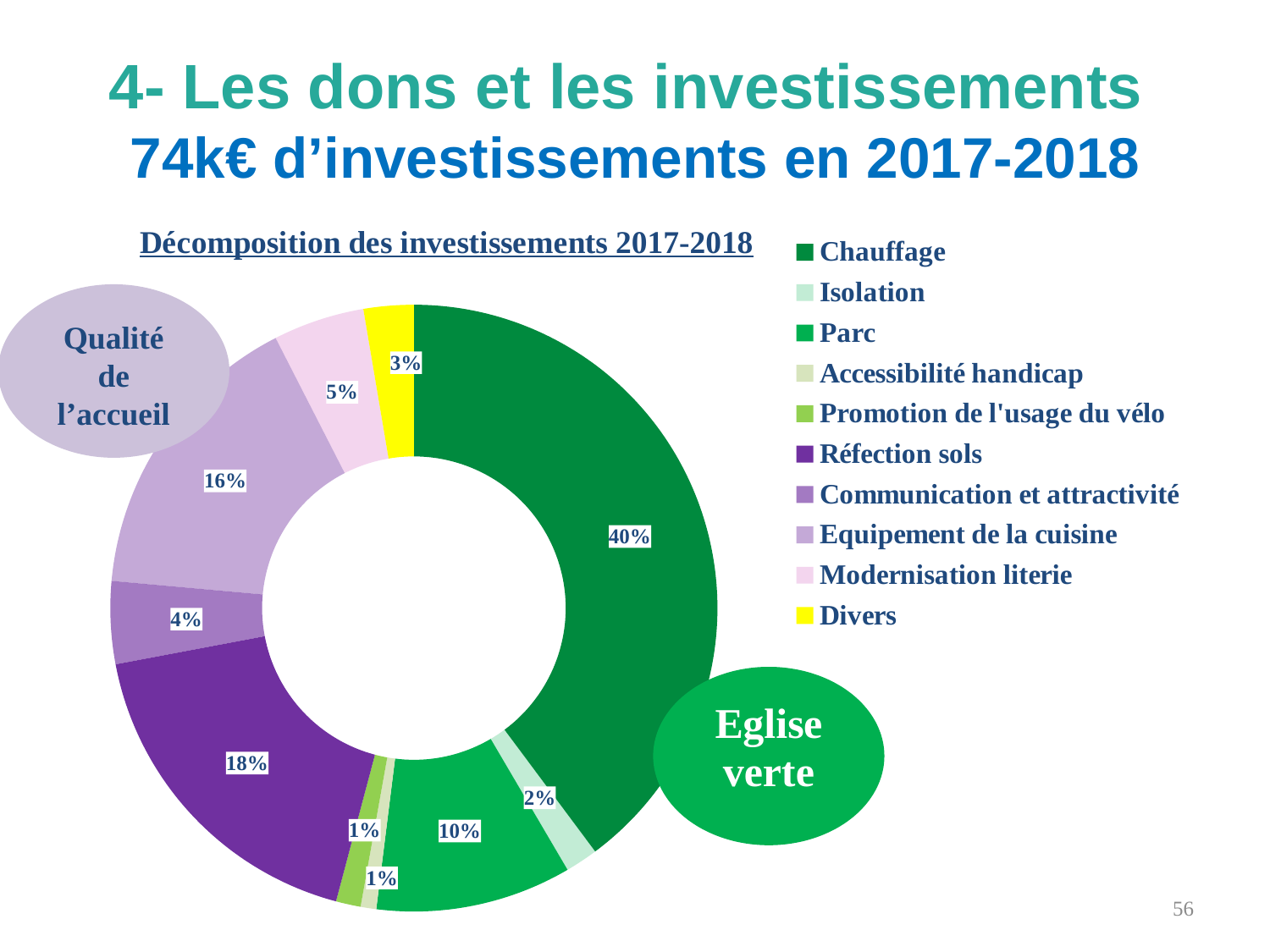
What is the title of the chart? Décomposition des investissements 2017-2018 What share of investments went to Chauffage? 40% What share of investments went to Equipement de la cuisine? 16% How many categories does the legend list? 10 Which category has the largest share of investments? Chauffage Which has the larger share, Modernisation literie or Communication et attractivité? Modernisation literie What is the difference in share between Chauffage and Réfection sols? 22% What kind of chart is shown on the slide? Pie chart (doughnut) What share of investments went to Parc? 10% What share of investments went to Réfection sols? 18% What share of investments went to Divers? 3% What colour is the Divers slice? Yellow